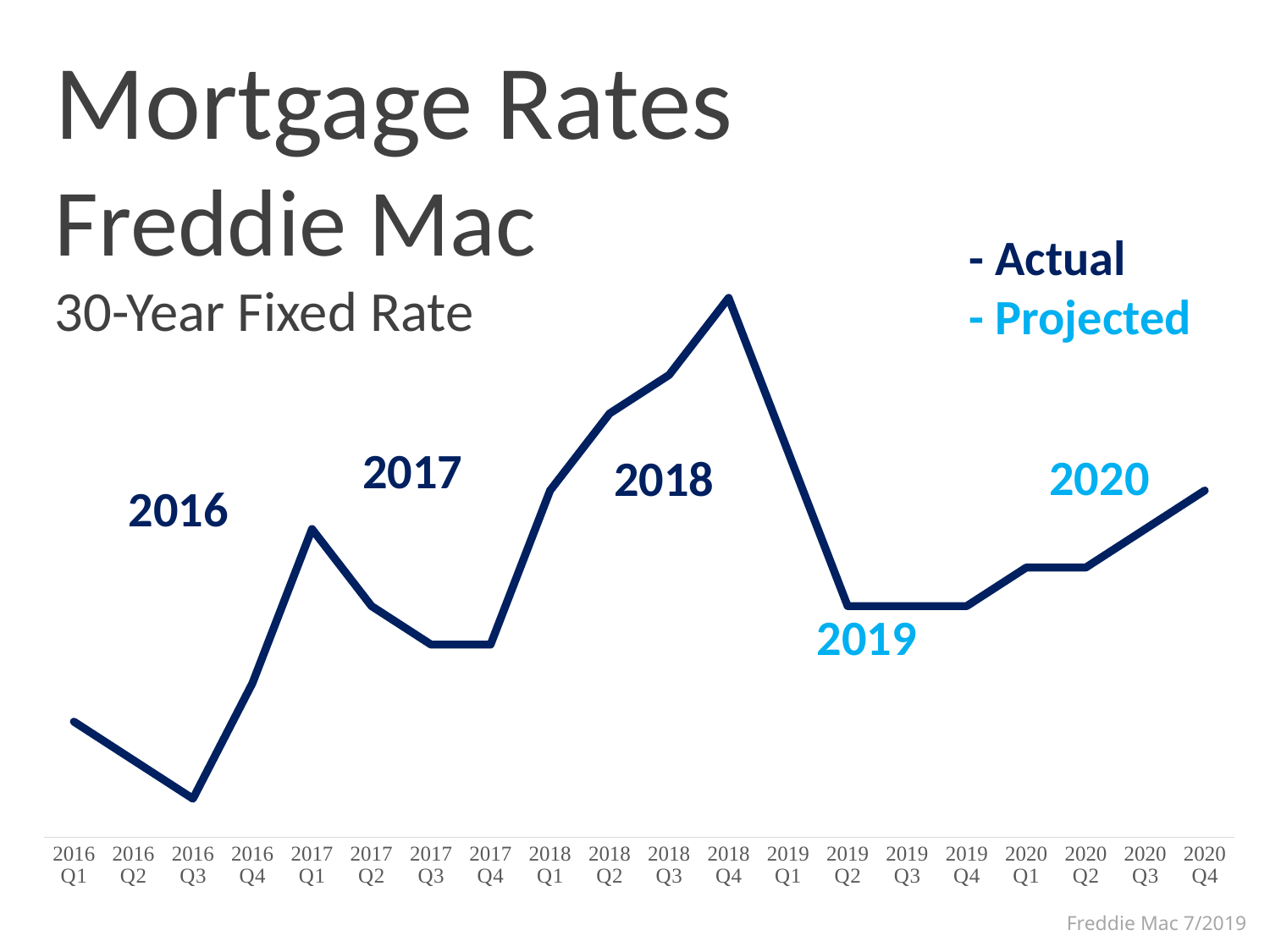
How many quarters are plotted along the x axis? 20 Does the rate rise or fall from 2016 Q3 to 2017 Q1? rise Does the rate rise or fall from 2019 Q4 to 2020 Q4? rise In which quarter does the mortgage rate reach its lowest point? 2016 Q3 What source is cited at the bottom of the slide? Freddie Mac 7/2019 Does the rate rise or fall from 2018 Q4 to 2019 Q2? fall Which is higher, the rate in 2017 Q1 or the rate in 2016 Q1? 2017 Q1 Which is higher, the rate in 2018 Q4 or the rate in 2019 Q2? 2018 Q4 How many series does the legend list? 2 In which quarter does the mortgage rate reach its highest point? 2018 Q4 What kind of chart is shown on the slide? line chart What are the two entries in the chart's legend? Actual and Projected